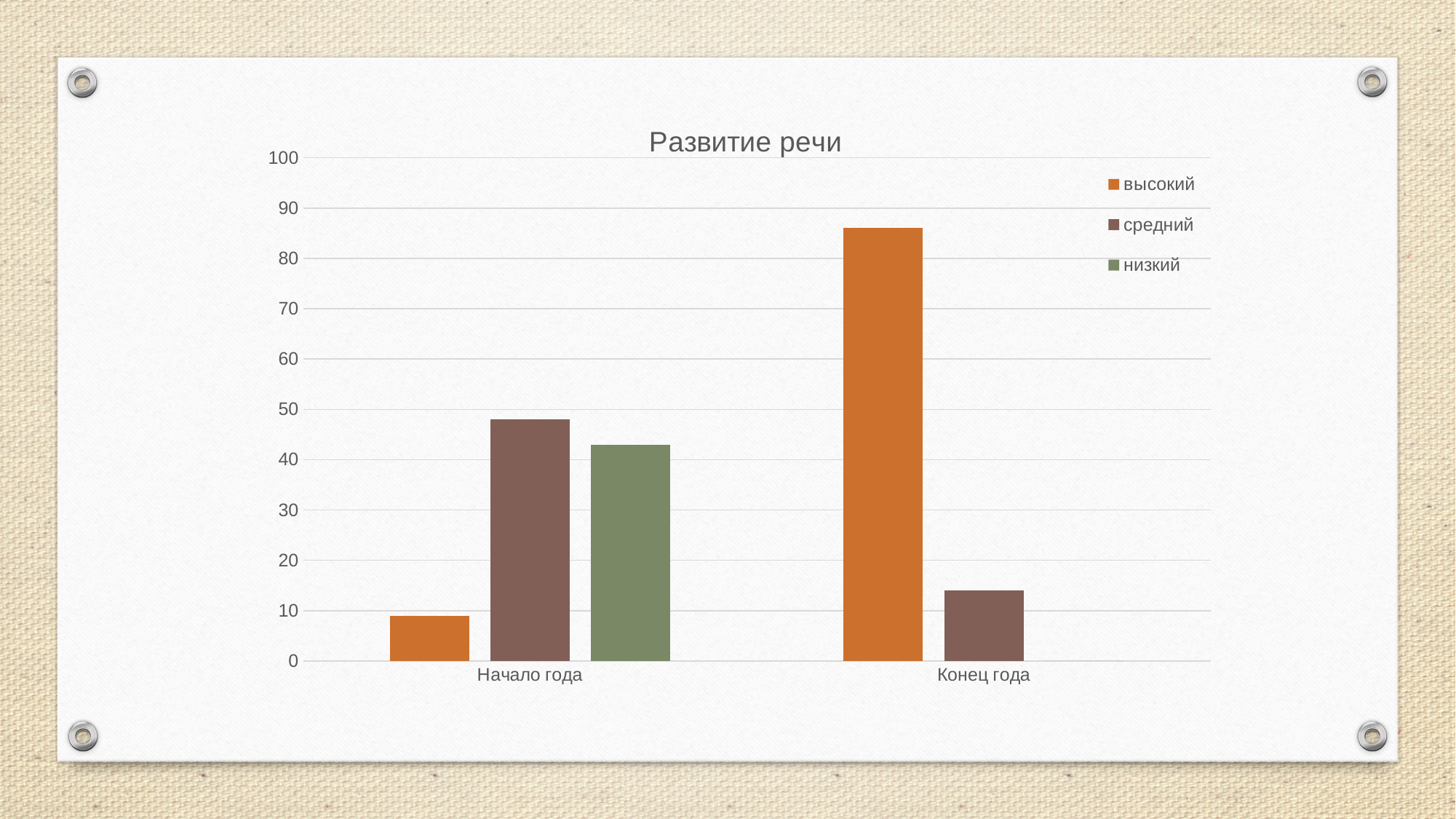
What kind of chart is shown on the slide? bar chart Does the value for средний rise or fall from Начало года to Конец года? fall Is the value for средний at Конец года greater or less than 20? less Which is larger: высокий at Начало года or высокий at Конец года? Конец года What is the title of the chart? Развитие речи Which series has the highest bar for Начало года? средний Is the value for высокий at Начало года greater or less than 20? less How many series does the legend list? 3 How many categories are shown on the x axis? 2 Which series has the highest bar for Конец года? высокий Which series has the lowest bar for Начало года? высокий Is the value for высокий at Конец года greater or less than 80? greater